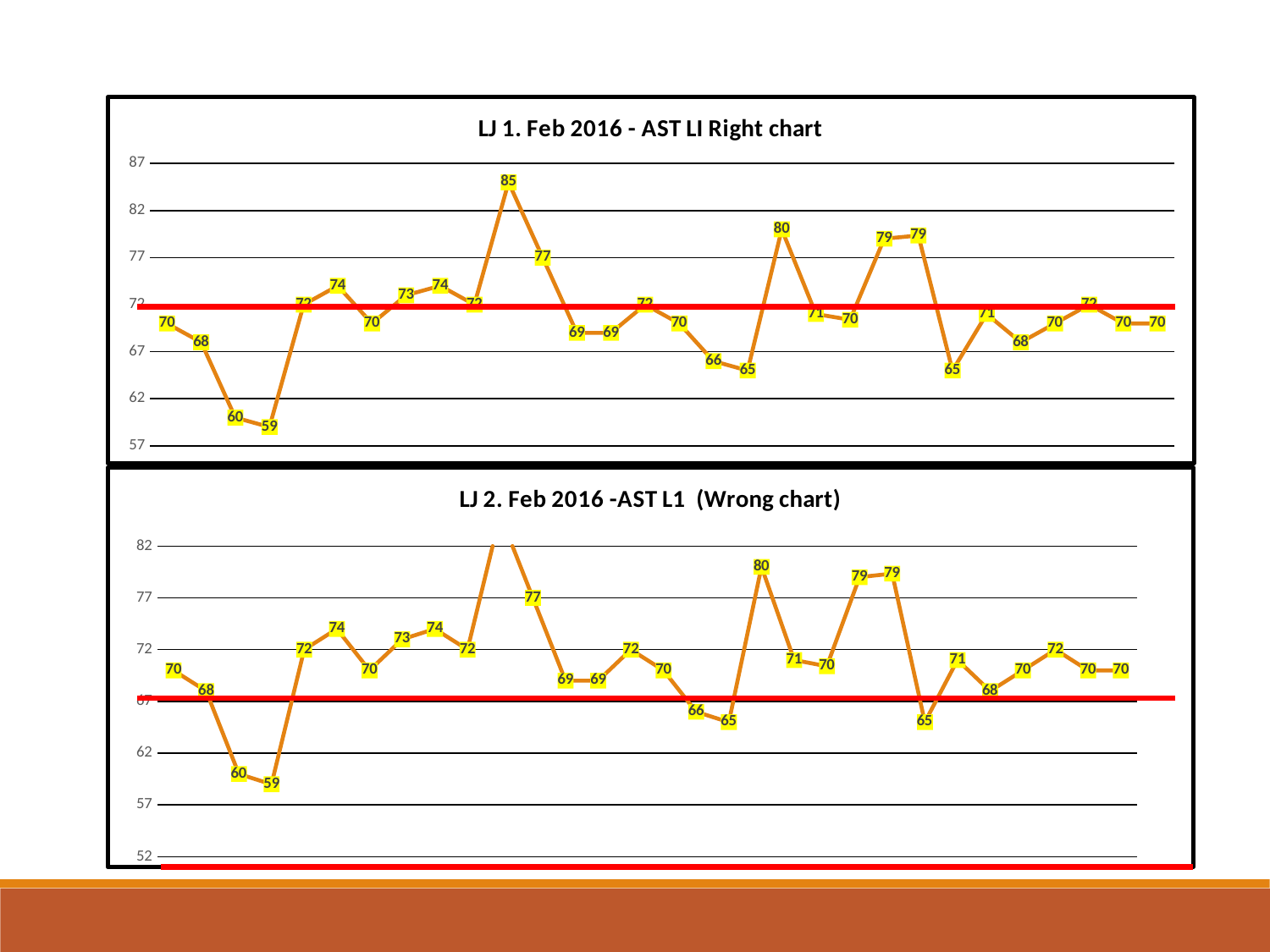
What is the lowest value shown on the y-axis of the bottom chart (LJ 2)? 52 In the top chart (LJ 1), is the value of the second data point (68) greater or less than 72? less In the bottom chart (LJ 2), what is the value of the last data point on the right? 70 In the bottom chart (LJ 2), what is the lowest data label shown? 59 What kind of chart is the top chart titled "LJ 1. Feb 2016 - AST LI Right chart"? line chart In the top chart (LJ 1), what is the highest data label shown? 85 In the bottom chart (LJ 2), is the data point labelled 80 greater or less than 77? greater In the top chart (LJ 1), what is the value of the first data point on the left? 70 In the top chart (LJ 1), what is the difference between the highest and lowest labelled values? 26 What is the highest value shown on the y-axis of the top chart (LJ 1)? 87 In the top chart (LJ 1), what is the lowest data label shown? 59 How many data points are plotted in the top chart (LJ 1)? 30